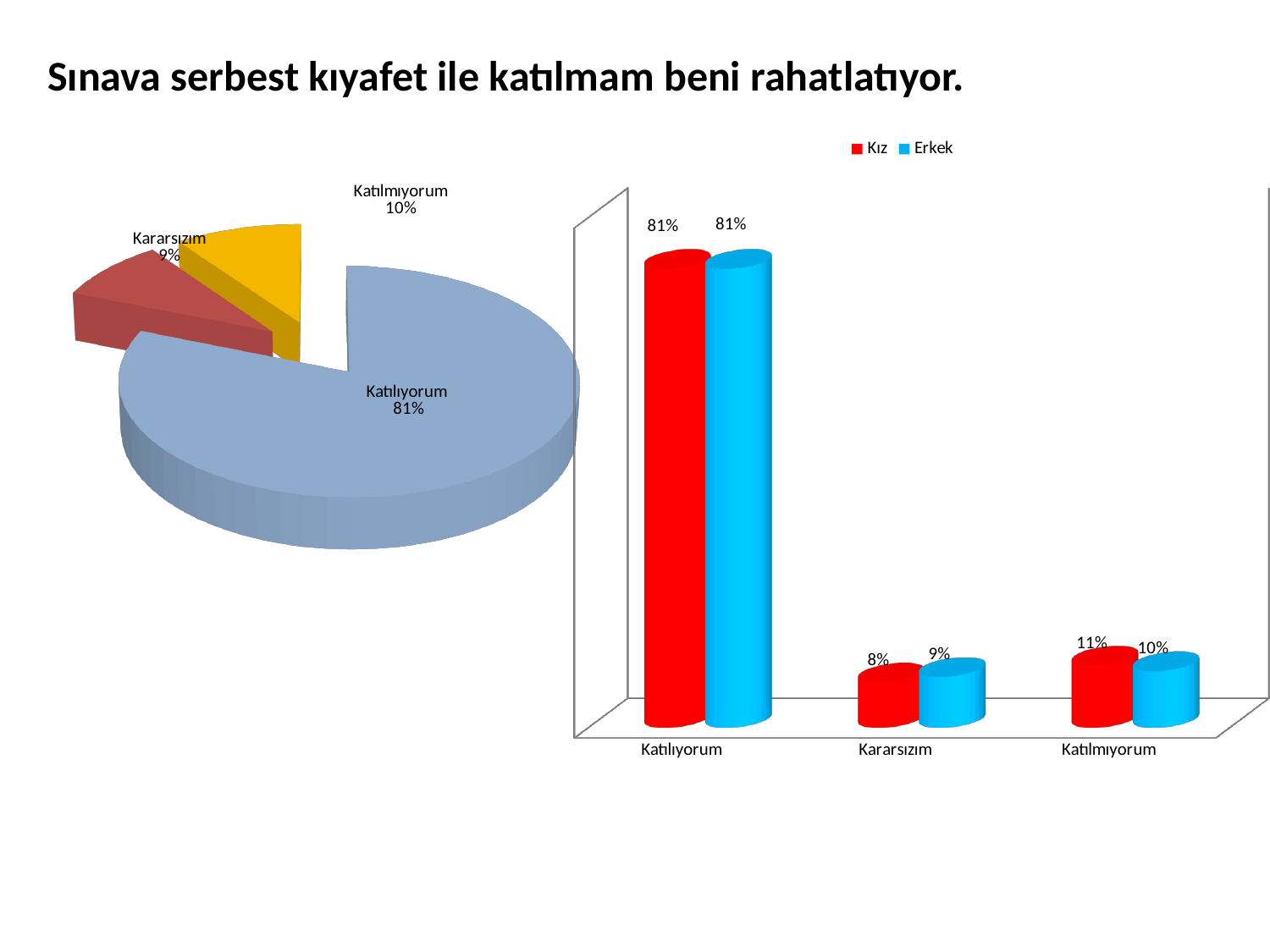
In the bar chart on the right, what is the value for Kız in the Kararsızım category? 8% In the bar chart on the right, which colour represents the Erkek series? Blue In the bar chart on the right, how many series does the legend list? 2 In the bar chart on the right, what is the difference between the Kız value for Katılıyorum and the Kız value for Katılmıyorum? 70% What kind of chart is on the right side of the slide? Bar chart In the pie chart on the left, what share does the Katılıyorum slice have? 81% In the pie chart on the left, which slice is the largest? Katılıyorum In the pie chart on the left, how many slices are there? 3 In the bar chart on the right, what is the value for Erkek in the Katılıyorum category? 81% In the bar chart on the right, what is the value for Erkek in the Katılmıyorum category? 10% In the pie chart on the left, what share does the Kararsızım slice have? 9% In the bar chart on the right, which category has the lowest value for Kız? Kararsızım